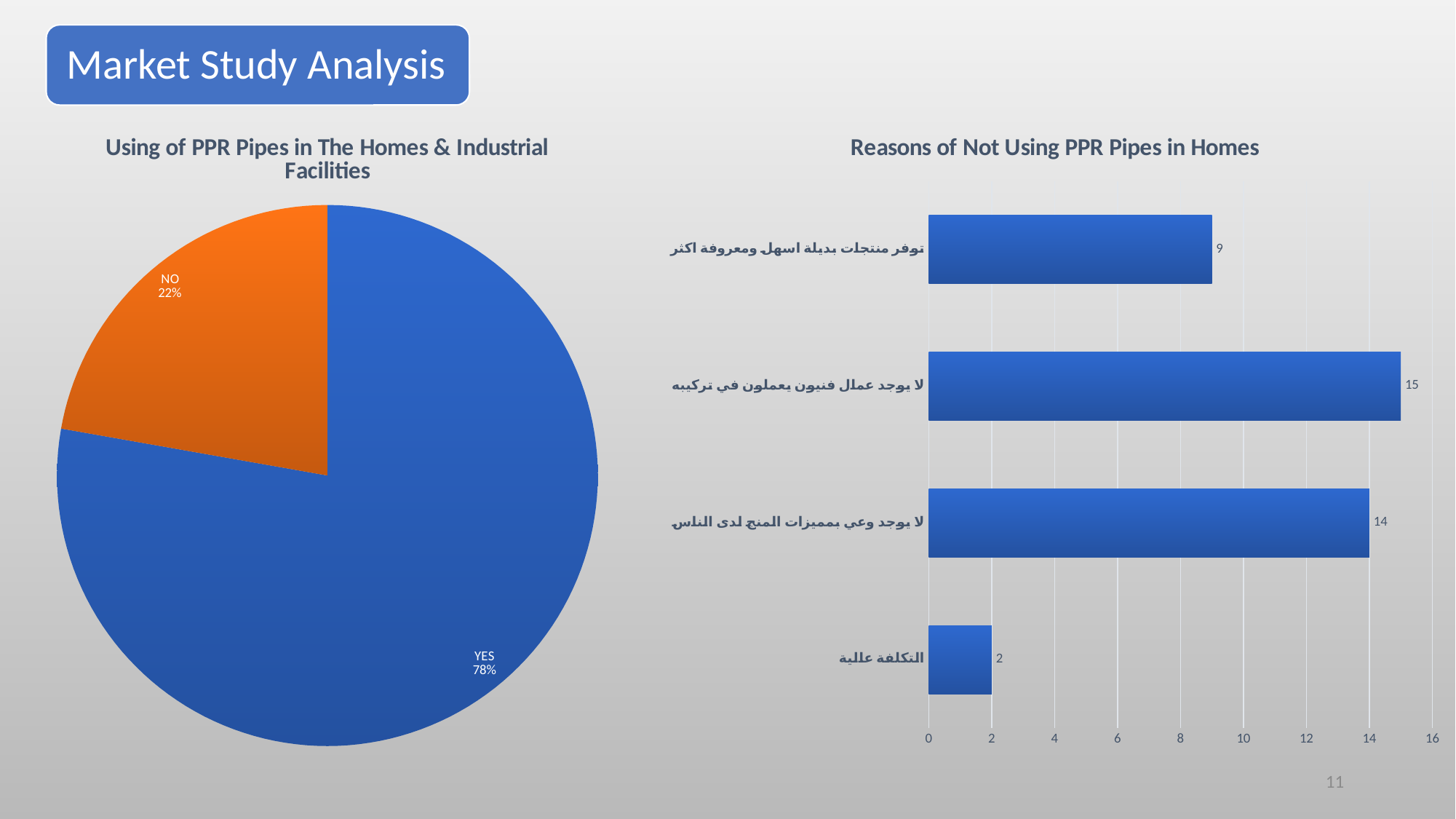
In the chart 'Reasons of Not Using PPR Pipes in Homes', what is the difference between the values for 'لا يوجد عمال فنيون يعملون في تركيبه' and 'لا يوجد وعي بمميزات المنتج لدى الناس'? 1 What is the title of the chart on the right side of the slide? Reasons of Not Using PPR Pipes in Homes How many slices does the pie chart 'Using of PPR Pipes in The Homes & Industrial Facilities' have? 2 In the chart 'Reasons of Not Using PPR Pipes in Homes', what is the value for 'توفر منتجات بديلة اسهل ومعروفة اكثر'? 9 What type of chart is 'Reasons of Not Using PPR Pipes in Homes'? Bar chart In the pie chart on the left, which slice is larger, YES or NO? YES In the chart 'Reasons of Not Using PPR Pipes in Homes', which reason has the lowest value? التكلفة عالية In the chart 'Reasons of Not Using PPR Pipes in Homes', which reason has the highest value? لا يوجد عمال فنيون يعملون في تركيبه In the pie chart 'Using of PPR Pipes in The Homes & Industrial Facilities', what share is labelled NO? 22% In the chart 'Reasons of Not Using PPR Pipes in Homes', what is the value for 'التكلفة عالية'? 2 How many categories are shown in the chart 'Reasons of Not Using PPR Pipes in Homes'? 4 In the pie chart 'Using of PPR Pipes in The Homes & Industrial Facilities', what share is labelled YES? 78%